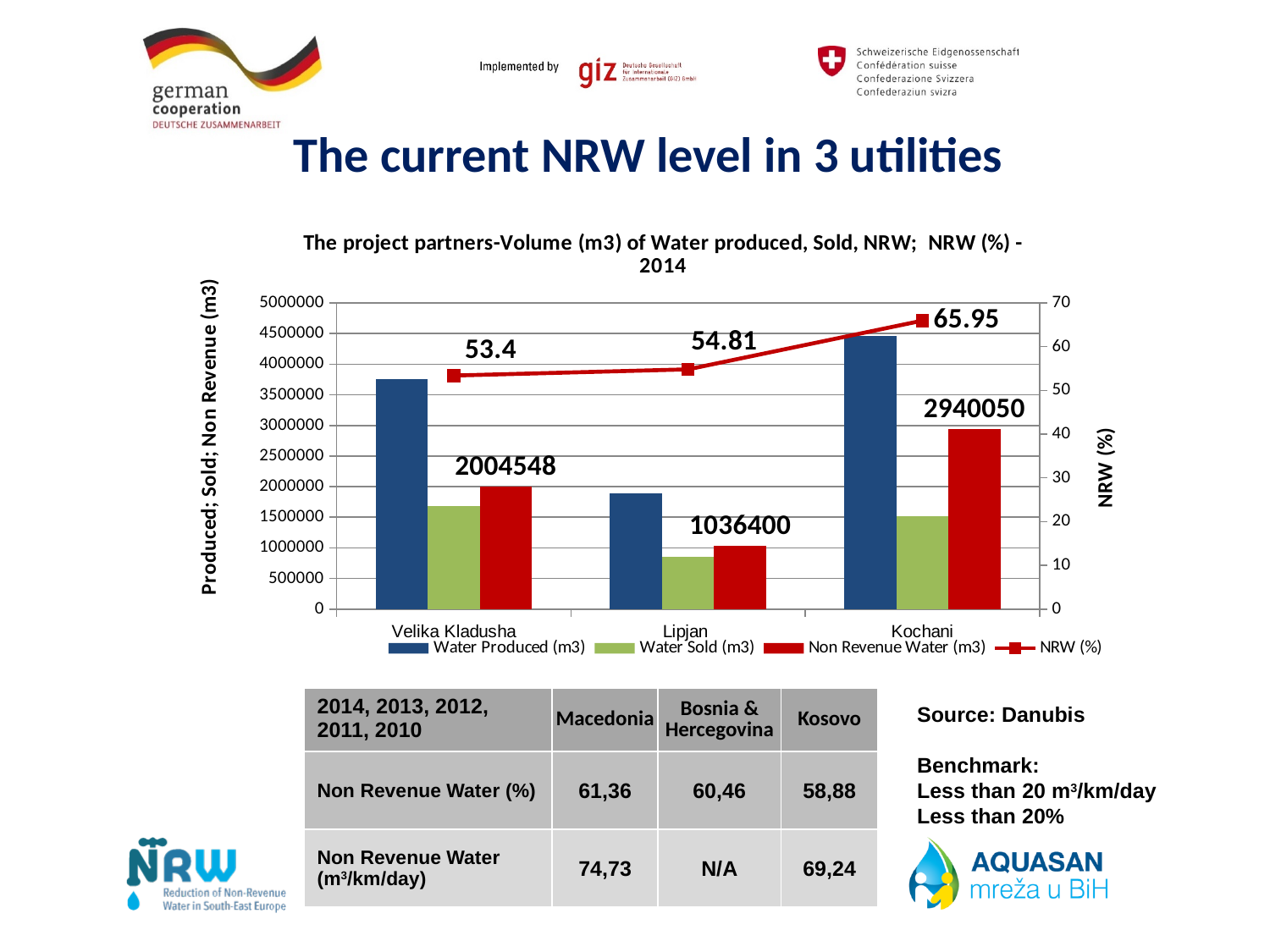
What is the difference in Non Revenue Water (m3) between Kochani and Velika Kladusha? 935502 What is the difference in NRW (%) between Kochani and Velika Kladusha? 12.55 Which utility has the highest Water Produced (m3)? Kochani How many series does the chart legend list? 4 Is the Water Sold (m3) value for Lipjan greater or less than 1000000? less What is the NRW (%) value for Velika Kladusha? 53.4 What is the NRW (%) value for Kochani? 65.95 Which utility has the highest NRW (%)? Kochani What is the Non Revenue Water (m3) value for Lipjan? 1036400 Is the Water Produced (m3) value for Kochani greater or less than 4000000? greater Which has a higher NRW (%), Lipjan or Velika Kladusha? Lipjan Which utility has the lowest Non Revenue Water (m3)? Lipjan